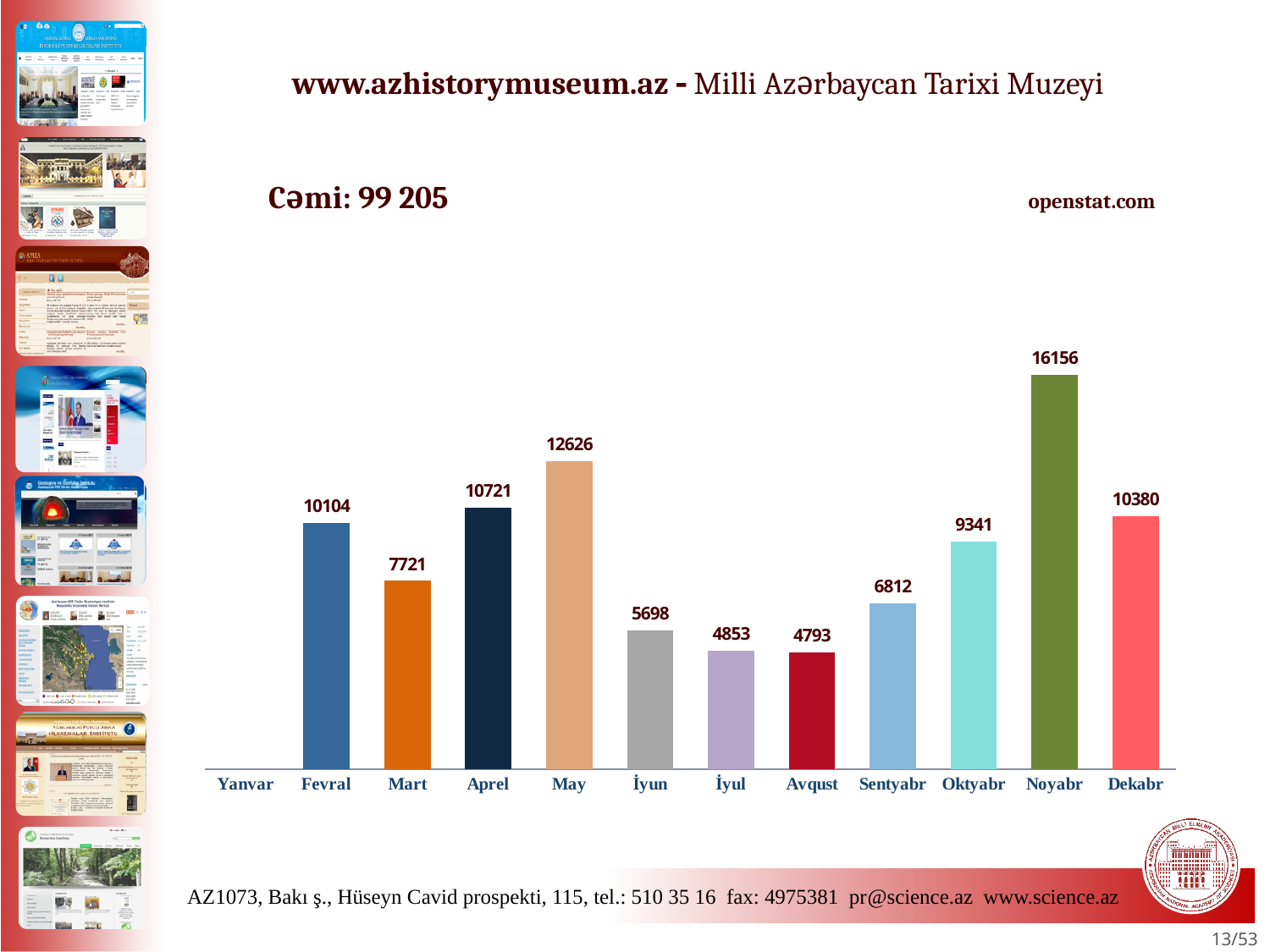
What kind of chart is shown on the slide? bar chart Which month has the highest value? Noyabr Do the values rise or fall from May to Avqust? fall What is the difference between the values for May and Aprel? 1905 What is the value for May? 12626 What is the value for Noyabr? 16156 What is the value for Avqust? 4793 What total (Cəmi) is stated on the slide? 99 205 Which month with a bar has the lowest value? Avqust What is the difference between the values for Noyabr and Dekabr? 5776 How many months are labeled on the x axis? 12 Which is larger, the value for Fevral or the value for Mart? Fevral